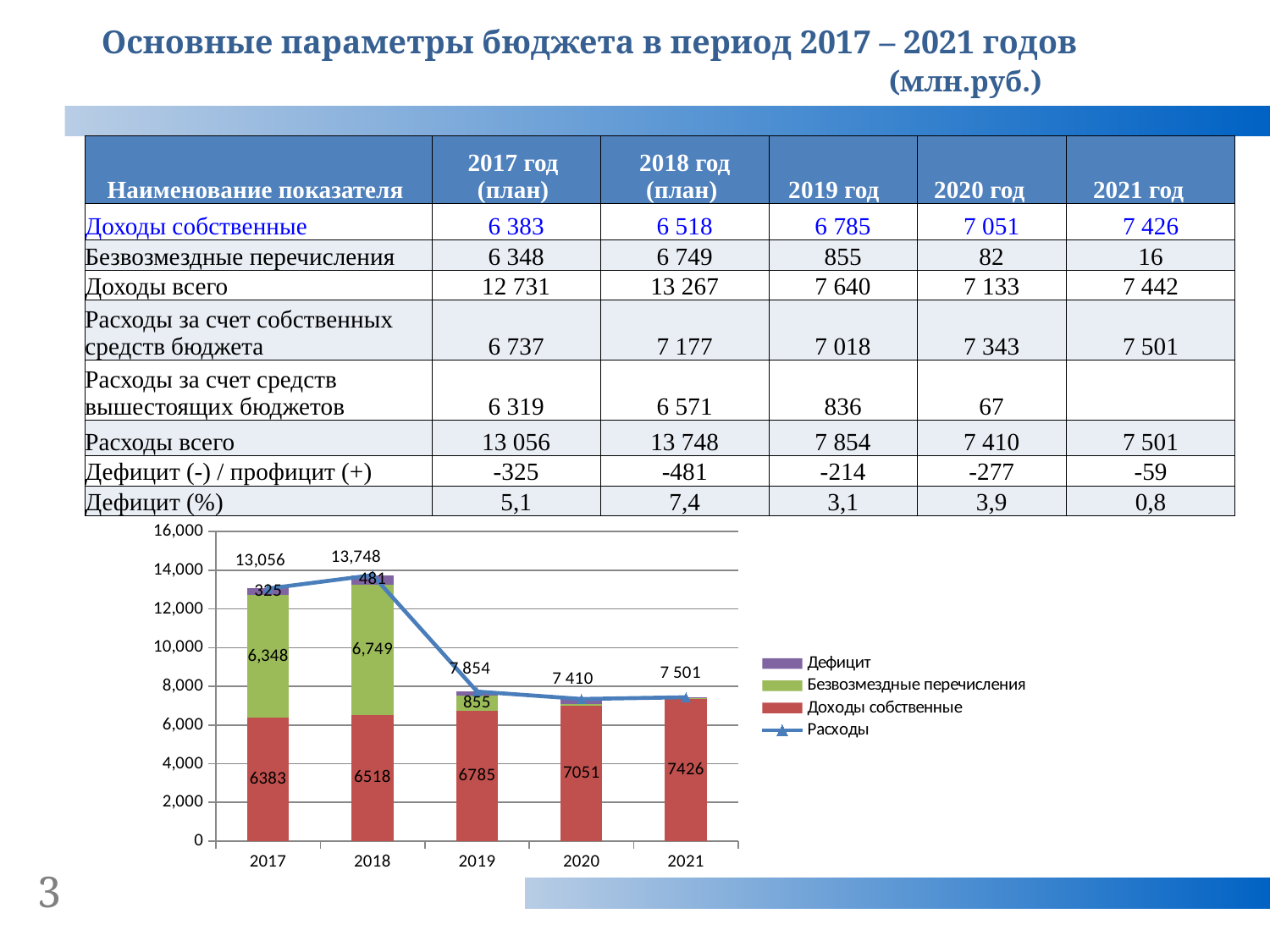
In the chart, which year has the lowest value for Доходы собственные? 2017 In the chart, what is the value of Дефицит for 2017? 325 In the chart, what is the value of Безвозмездные перечисления for 2019? 855 In the chart, which year has the highest value on the Расходы line? 2018 Do the values for Доходы собственные rise or fall from 2017 to 2021 in the chart? rise In the chart, what is the difference between Доходы собственные in 2021 and in 2017? 1043 In the chart, is the Расходы value for 2019 greater or less than 8,000? less How many years are shown on the x axis of the chart? 5 In the chart, what is the value of the Расходы line for 2018? 13,748 In the chart, is Безвозмездные перечисления larger in 2017 or in 2018? 2018 How many series does the chart legend list? 4 In the chart, what is the value of Доходы собственные for 2021? 7426